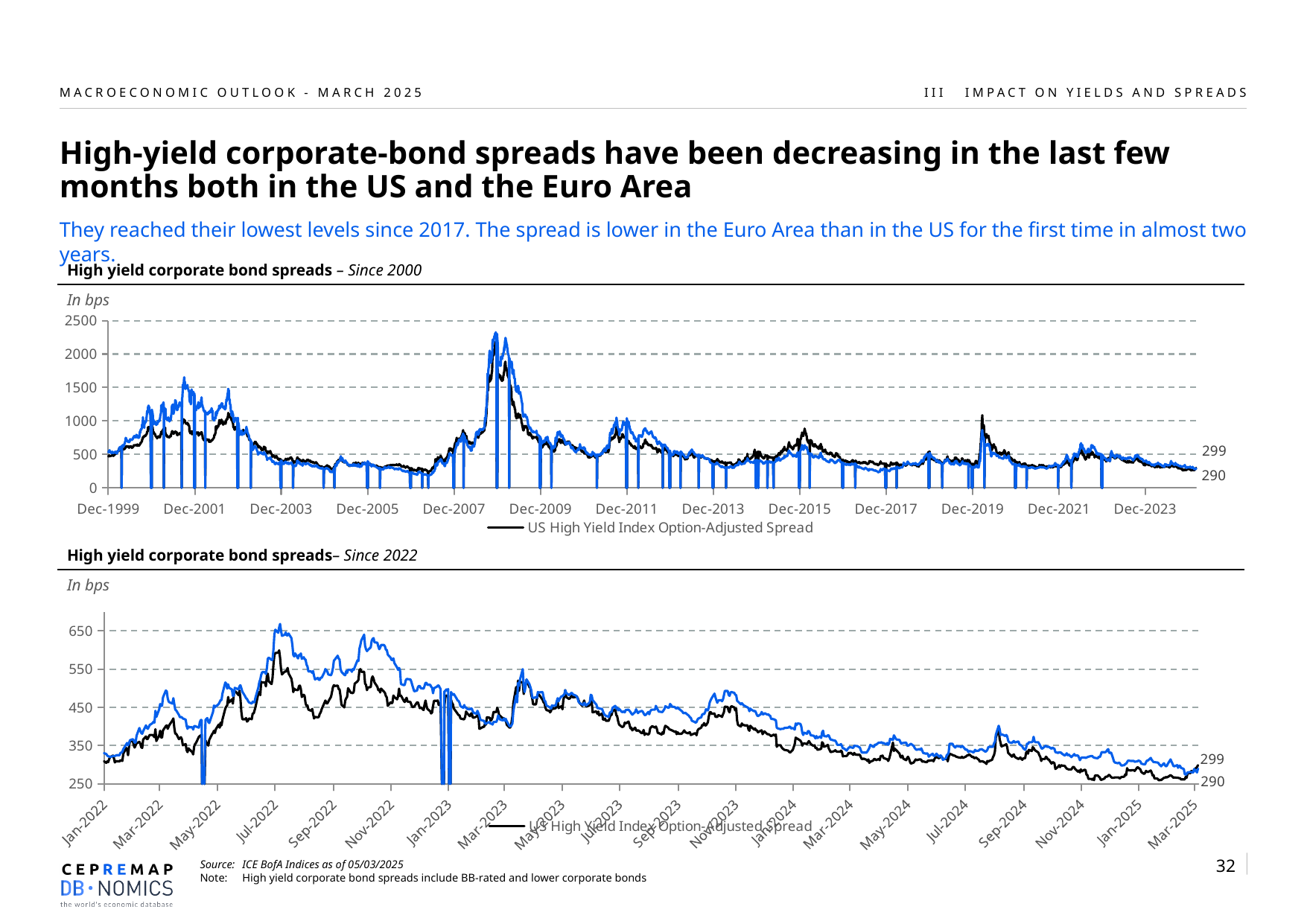
What is the first date label on the x axis of the 'Since 2000' chart? Dec-1999 What kind of chart is the 'High yield corporate bond spreads – Since 2000' chart? line chart In the 'Since 2000' chart, what is the latest value labelled for the US High Yield Index Option-Adjusted Spread? 299 In the 'Since 2000' chart, is the peak of the US High Yield Index Option-Adjusted Spread around 2008-2009 greater or less than 2000? greater In the 'Since 2000' chart, is the US High Yield Index Option-Adjusted Spread at Dec-2005 greater or less than 500? less In the 'Since 2022' chart, does the US High Yield Index Option-Adjusted Spread generally rise or fall between Mar-2023 and Mar-2025? fall In the 'Since 2022' chart, is the US High Yield Index Option-Adjusted Spread at Jul-2022 greater or less than 450? greater What is the last date label on the x axis of the 'Since 2022' chart? Mar-2025 What series name is shown in the legend of the 'Since 2000' chart? US High Yield Index Option-Adjusted Spread In the 'Since 2000' chart, what is the highest value shown on the y axis? 2500 In the 'Since 2022' chart, what is the latest value labelled for the US High Yield Index Option-Adjusted Spread? 299